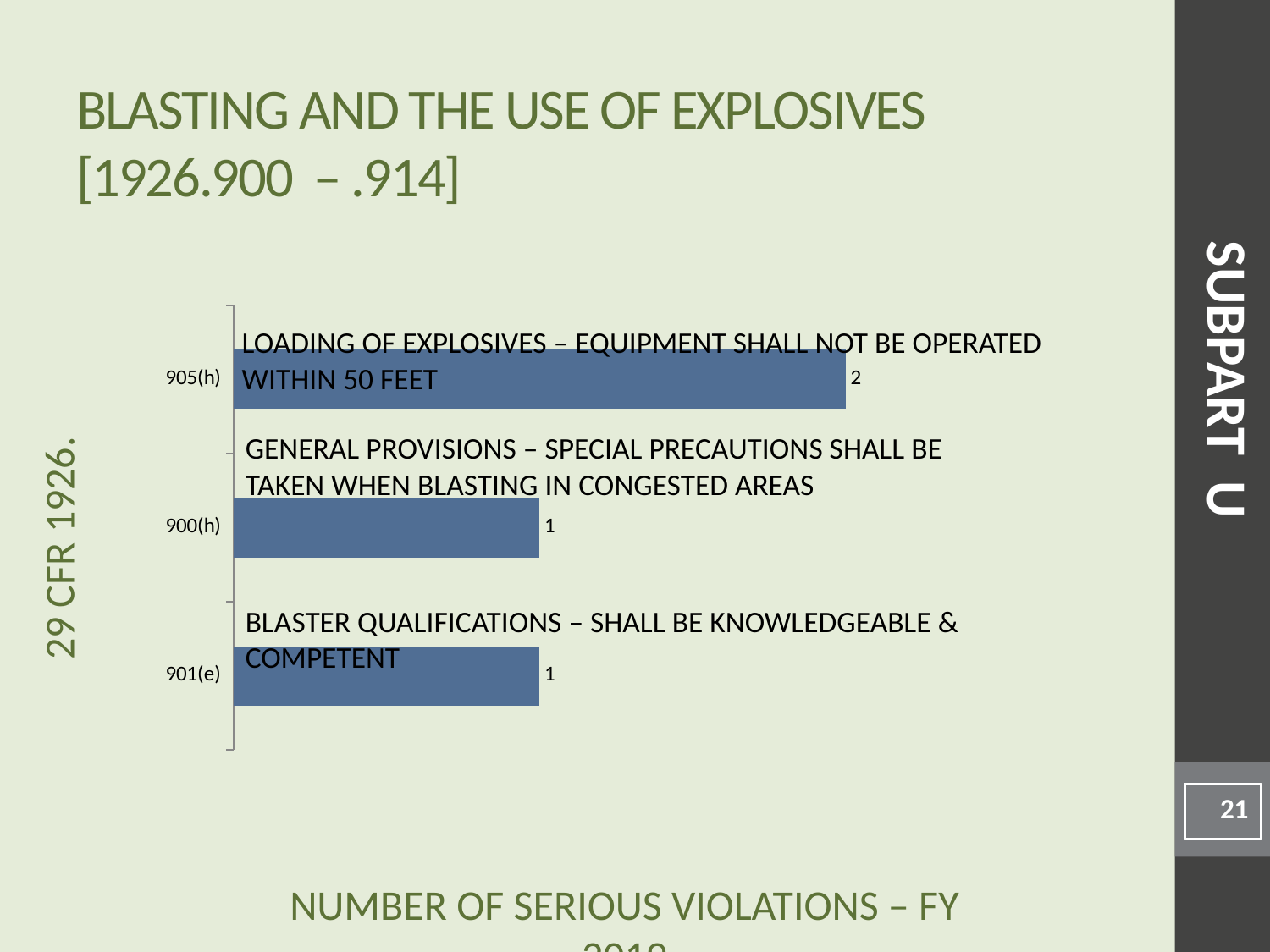
Do the values for 900(h) and 901(e) differ? No What colour are the bars in the chart? Blue What is the total of all the values shown in the chart? 4 How many categories are shown in the chart? 3 What is the difference between the values for 905(h) and 900(h)? 1 What is the text label on the bar for 901(e)? BLASTER QUALIFICATIONS – SHALL BE KNOWLEDGEABLE & COMPETENT Which category has the highest value? 905(h) What is the value for 901(e)? 1 Which is larger, the value for 905(h) or the value for 901(e)? 905(h) What kind of chart is shown on the slide? Bar chart What is the value for 900(h)? 1 What is the value for 905(h)? 2